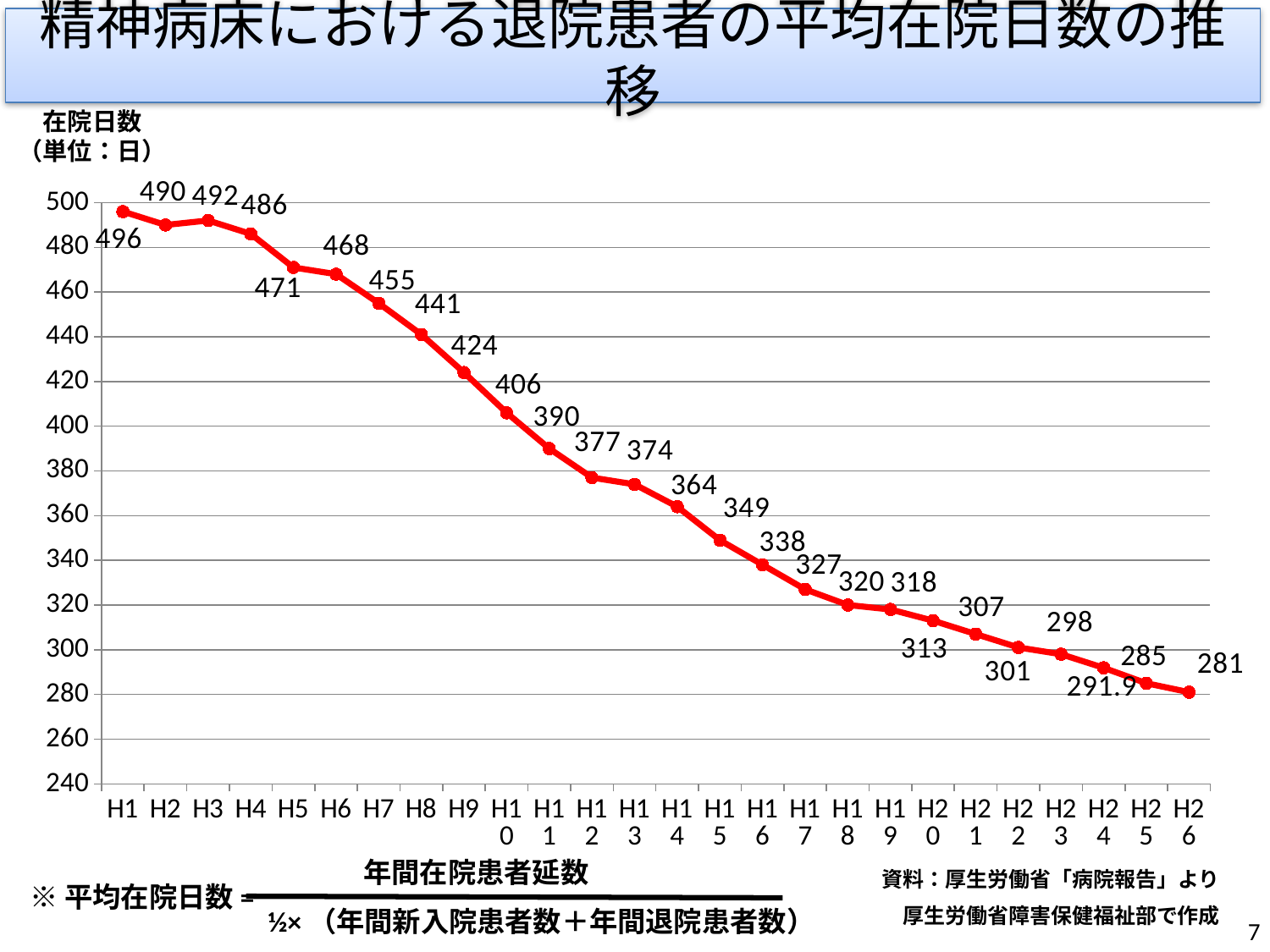
What is the average length of stay (在院日数) for H1? 496 Is the value for H15 greater or less than 340? greater What is the value plotted for H24? 291.9 What kind of chart is shown on the slide? line chart Which year has the highest average length of stay? H1 Which year has the lowest average length of stay? H26 Do the values generally rise or fall from H1 to H26? fall How many years (data points) are plotted on the chart? 26 Which is larger, the value for H2 or the value for H3? H3 What is the difference between the values for H1 and H26? 215 What is the value plotted for H26? 281 What is the value plotted for H10? 406